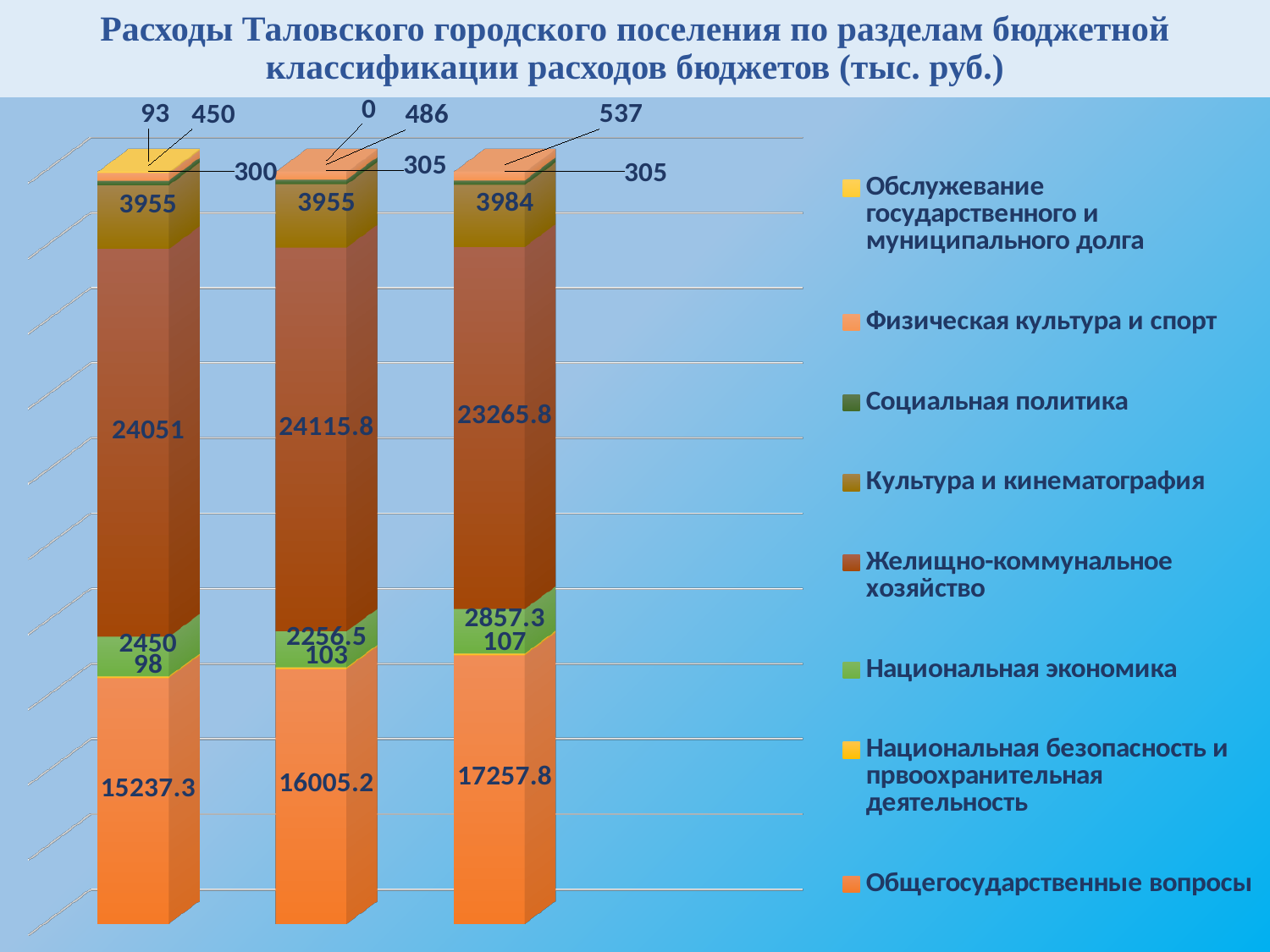
What is the value of the Жилищно-коммунальное хозяйство segment in the rightmost bar? 23265.8 What is the difference between the Национальная экономика values in the rightmost and middle bars? 600.8 Which is larger: the Жилищно-коммунальное хозяйство value in the middle bar or in the rightmost bar? The middle bar (24115.8) What is the value of the Культура и кинематография segment in the rightmost bar? 3984 Which bar has the highest value for Общегосударственные вопросы? The rightmost bar (17257.8) How many series does the legend list? 8 What is the difference between the Общегосударственные вопросы values in the rightmost and leftmost bars? 2020.5 What is the value of the Общегосударственные вопросы segment in the leftmost bar? 15237.3 Which bar has the lowest value for Национальная экономика? The middle bar (2256.5) What unit is stated in the chart title for the expenditure values? тыс. руб. What kind of chart is shown on the slide? Stacked bar chart How many stacked bars are plotted in the chart? 3